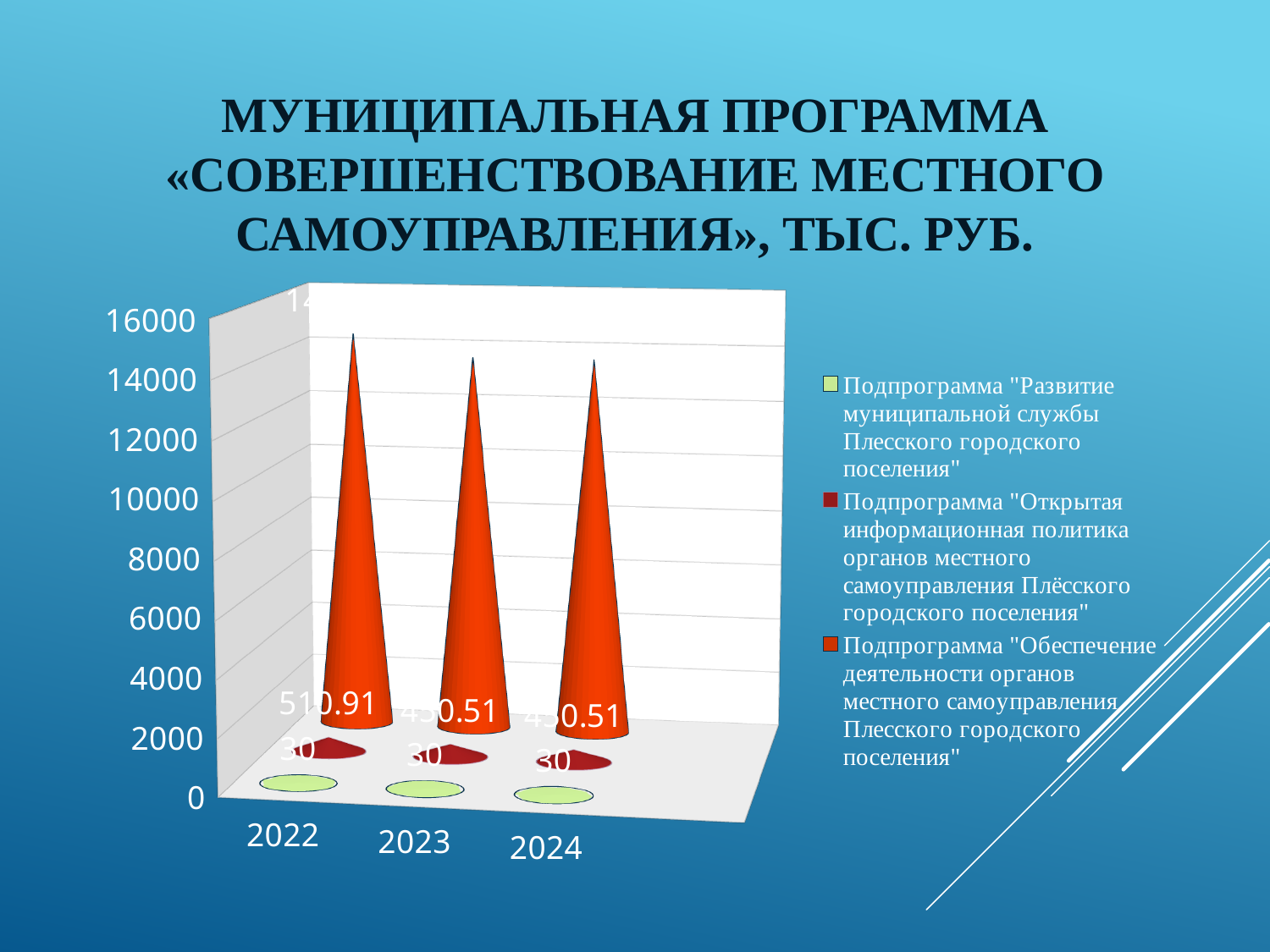
How many years are shown on the x axis of the chart? 3 In which year is the value for the subprogram "Открытая информационная политика" highest? 2022 What is the value for 2024 for the subprogram "Открытая информационная политика органов местного самоуправления Плёсского городского поселения"? 450.51 What is the value for 2022 for the subprogram "Открытая информационная политика органов местного самоуправления Плёсского городского поселения"? 510.91 How many series does the chart legend list? 3 Is the 2022 value for the subprogram "Обеспечение деятельности органов местного самоуправления Плесского городского поселения" greater or less than 10000? greater Which subprogram has the largest value in 2022? Подпрограмма "Обеспечение деятельности органов местного самоуправления Плесского городского поселения" In what units are the values on the chart expressed, according to the slide title? тыс. руб. What is the value for 2022 for the subprogram "Развитие муниципальной службы Плесского городского поселения"? 30 What kind of chart is shown on the slide? bar chart What is the difference between the 2022 and 2023 values for the subprogram "Открытая информационная политика"? 60.40 What is the value for 2023 for the subprogram "Открытая информационная политика органов местного самоуправления Плёсского городского поселения"? 450.51